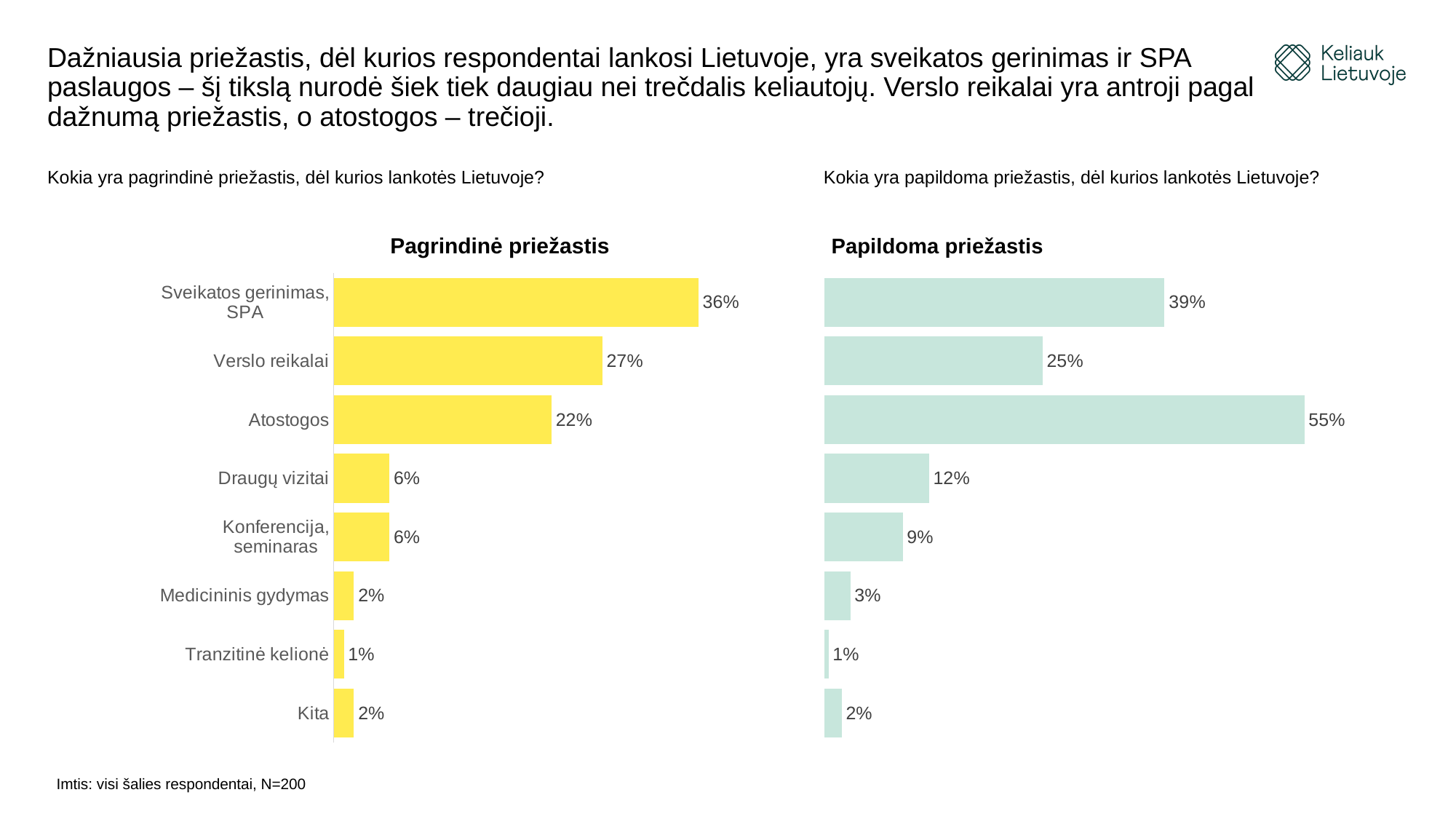
What kind of chart is the 'Pagrindinė priežastis' chart? Bar chart In the 'Papildoma priežastis' chart, which row has the highest value? Atostogos In the 'Pagrindinė priežastis' chart, which category has the highest value? Sveikatos gerinimas, SPA In the 'Pagrindinė priežastis' chart, what is the difference between Sveikatos gerinimas, SPA and Verslo reikalai? 9% In the 'Papildoma priežastis' chart, what is the value for the Atostogos row? 55% In the 'Papildoma priežastis' chart, what is the value for the Draugų vizitai row? 12% How many categories does the 'Pagrindinė priežastis' chart show? 8 In the 'Pagrindinė priežastis' chart, which category has the lowest value? Tranzitinė kelionė In the 'Papildoma priežastis' chart, what is the difference between the Atostogos row and the Sveikatos gerinimas, SPA row? 16% Which is larger: Atostogos in the 'Pagrindinė priežastis' chart or the Atostogos row in the 'Papildoma priežastis' chart? Papildoma priežastis In the 'Pagrindinė priežastis' chart, what is the value for Atostogos? 22% In the 'Pagrindinė priežastis' chart, what is the value for Verslo reikalai? 27%